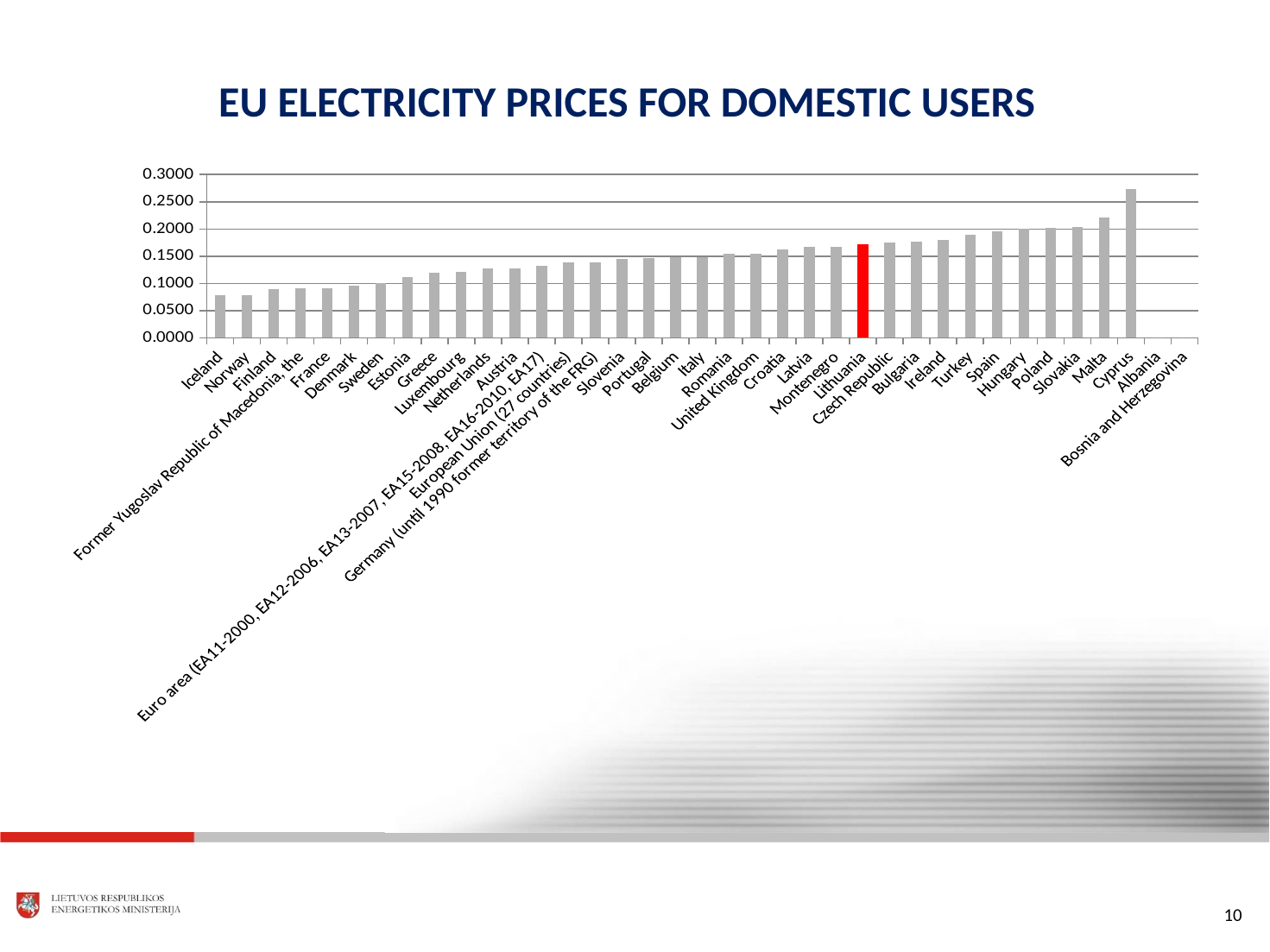
Which has a higher value, Lithuania or Finland? Lithuania Do the bar values generally rise or fall from left to right along the x axis? rise Is the value for Finland greater or less than 0.1000? less What kind of chart is shown on the slide? bar chart Is the value for Malta greater or less than 0.2000? greater Which has a higher value, Cyprus or Malta? Cyprus Which country's bar is highlighted in red? Lithuania Is the value for Cyprus greater or less than 0.2500? greater What is the title of the chart? EU ELECTRICITY PRICES FOR DOMESTIC USERS Which category has the highest electricity price in the chart? Cyprus